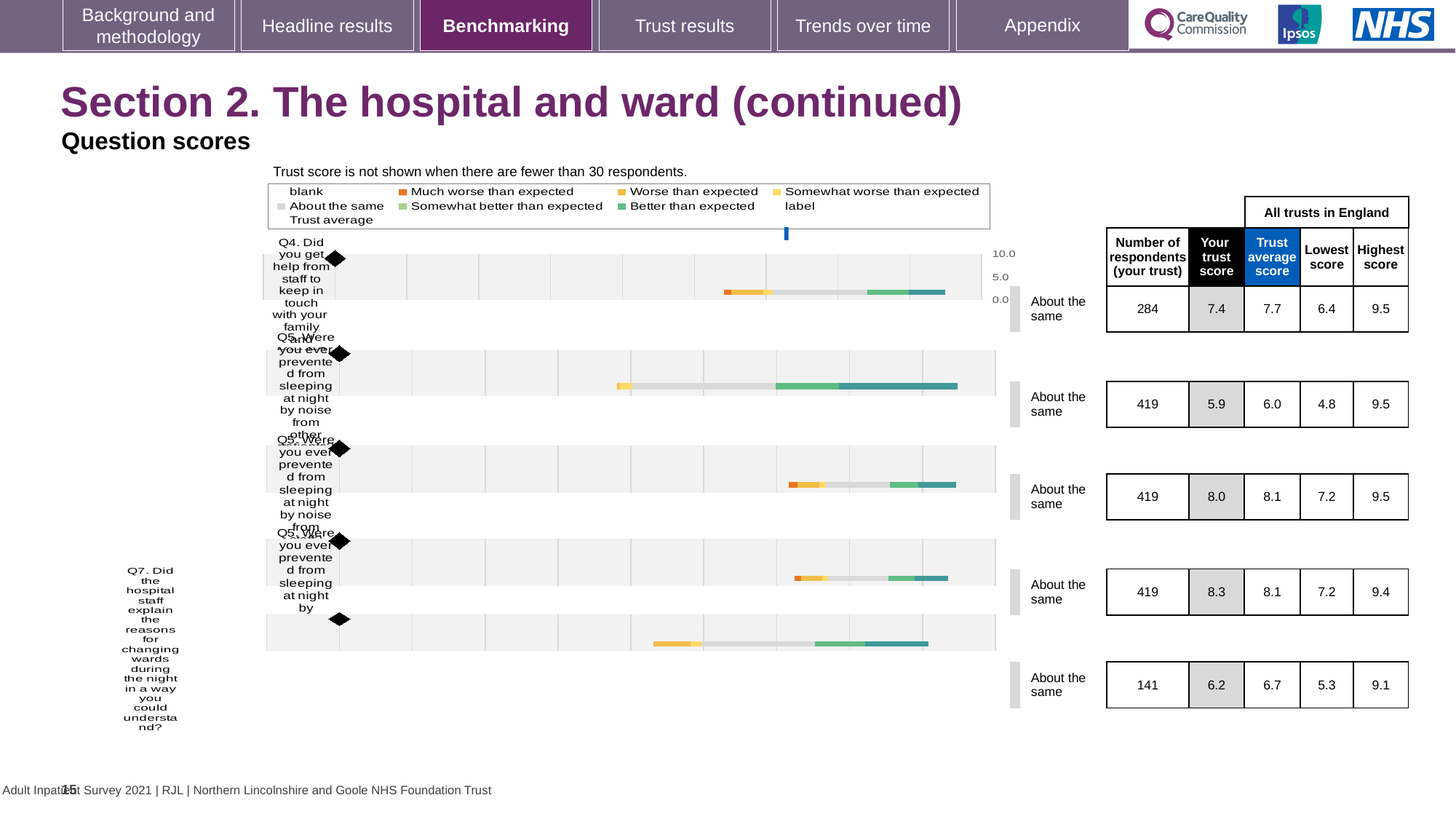
How many respondents (your trust) are shown for Q4? 284 What is the highest score across all trusts in England for Q7? 9.1 How many respondents (your trust) are shown for Q7? 141 What is the highest 'Your trust score' value shown in the table on this slide? 8.3 What is the 'Your trust score' for Q4 (help from staff to keep in touch with family and friends)? 7.4 What is the trust average score for Q7 (explaining reasons for changing wards during the night)? 6.7 What kind of chart is used to show the question scores on this slide? bar chart What benchmark category is shown next to the Q4 bar? About the same For Q7, which is larger: your trust score or the trust average score? Trust average score What is the lowest 'Your trust score' value shown in the table on this slide? 5.9 For Q4, what is the difference between the trust average score and your trust score? 0.3 How many question rows (bars) are shown in the chart? 5